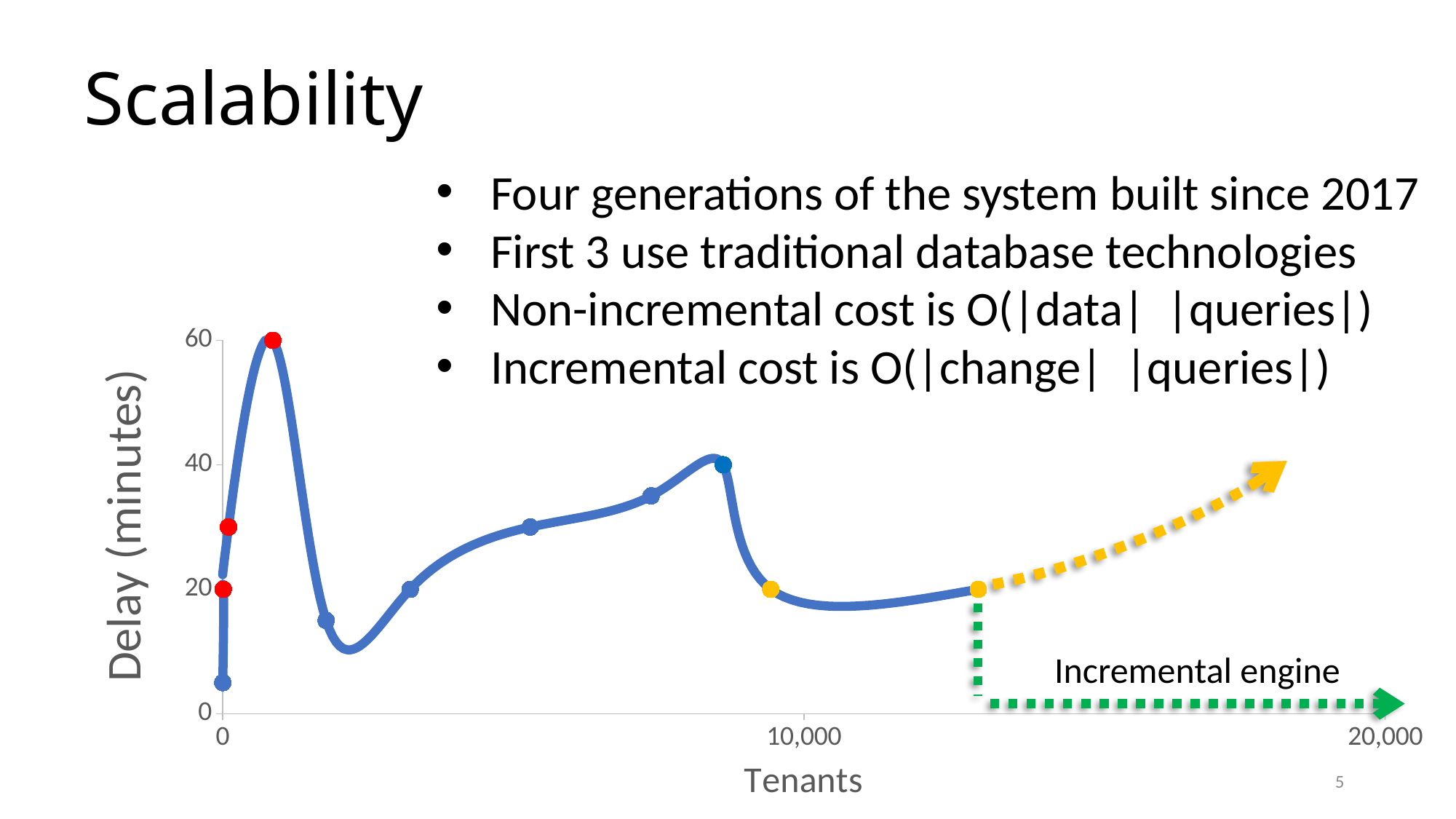
What kind of chart is shown on the slide? line chart Is the peak delay of the curve greater or less than 40 minutes? greater Is the delay at 0 tenants (the first point) greater or less than 20 minutes? less What is the highest delay value reached by the curve, in minutes? 60 Immediately after the peak at 60 minutes, does the delay rise or fall as tenants increase? fall What text annotation appears next to the green dashed arrow on the chart? Incremental engine Is the delay at 10,000 tenants greater or less than 40 minutes? less How many tick values are labelled on the y axis? 4 What is the highest tick value shown on the y axis (Delay)? 60 Which is larger: the delay at the peak near the start of the curve, or the delay at the second peak just before 10,000 tenants? the peak near the start What is the largest tick value shown on the x axis (Tenants)? 20,000 What is the label of the x axis of the chart? Tenants